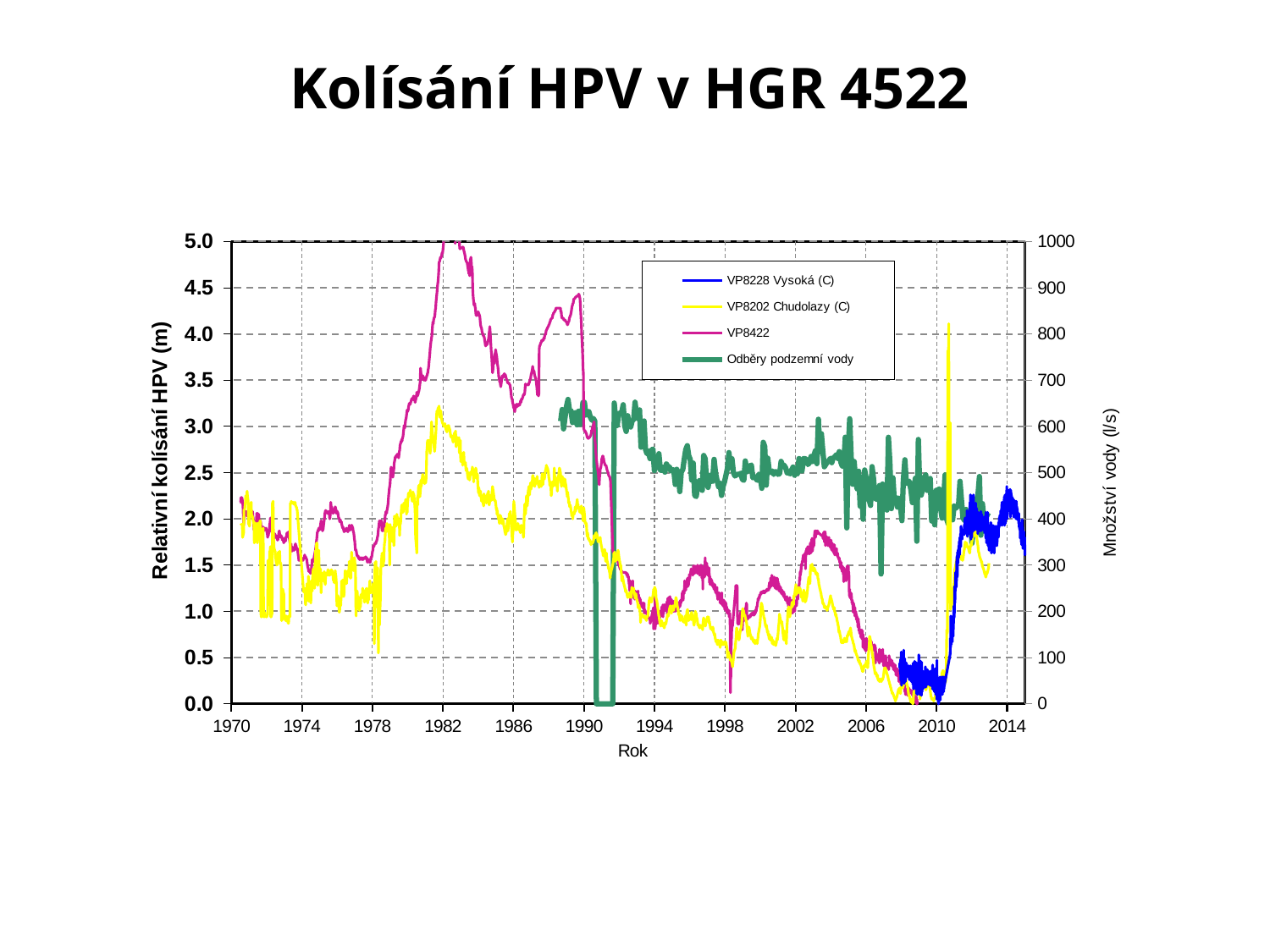
What kind of chart is shown on the slide? line chart Is the value for VP8202 Chudolazy (C) in 2006 greater or less than 1.0? less Is the value for VP8228 Vysoká (C) in 2008 greater or less than 1.0? less In 1982, which series has the higher value, VP8422 or VP8202 Chudolazy (C)? VP8422 Does the VP8228 Vysoká (C) series rise or fall between 2010 and 2012? rise Which series in the legend is drawn in green? Odběry podzemní vody What is the title of the chart? Kolísání HPV v HGR 4522 Does the VP8422 series rise or fall between 2003 and 2009? fall Is the value for VP8422 in 1982 greater or less than 4.0? greater How many series does the legend list? 4 In 2012, which series has the higher value, VP8228 Vysoká (C) or VP8202 Chudolazy (C)? VP8228 Vysoká (C)